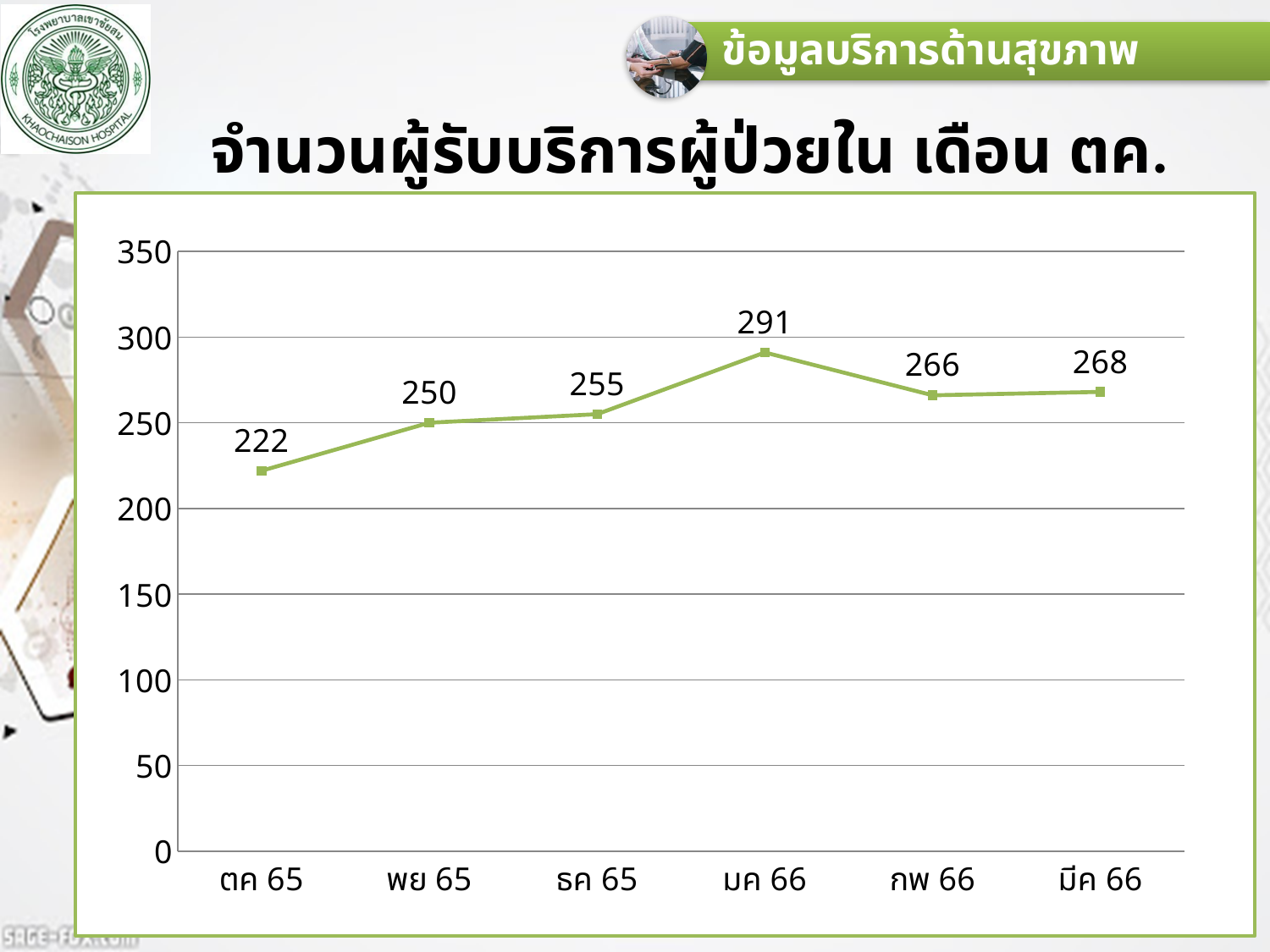
Which is larger, the value for กพ 66 or the value for พย 65? กพ 66 What is the value for ตค 65? 222 What is the difference between the values for มค 66 and ตค 65? 69 What is the difference between the values for ธค 65 and พย 65? 5 How many months are plotted on the x axis? 6 What is the value for มีค 66? 268 What is the value for มค 66? 291 Is the value for มค 66 greater or less than 300? less Do the values rise or fall from ตค 65 to มค 66? rise Which month has the highest value? มค 66 What kind of chart is shown? line chart Which month has the lowest value? ตค 65